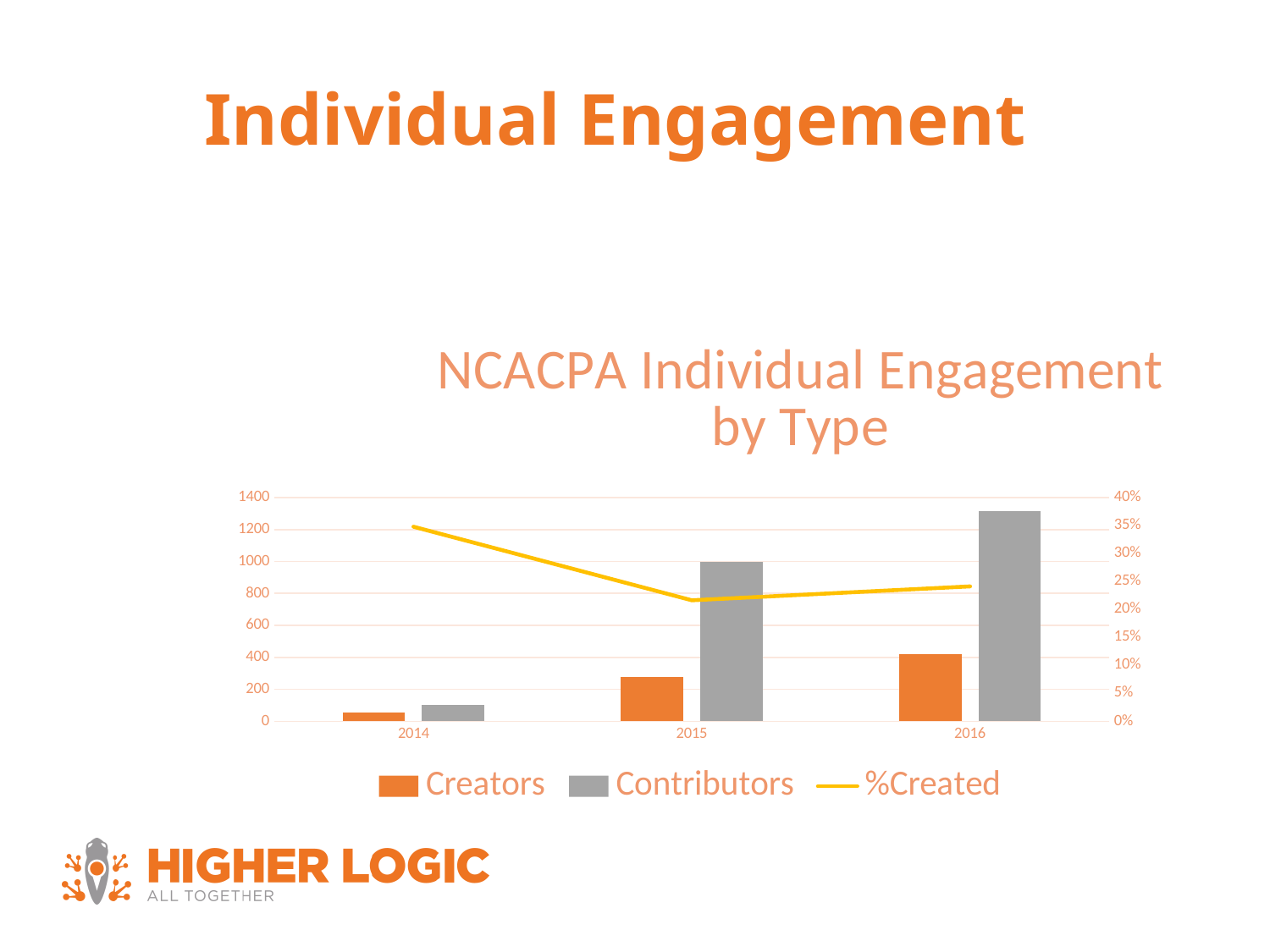
Is the %Created value for 2014 greater or less than 30%? greater Which year has the highest number of Contributors? 2016 Is the value for Creators in 2015 greater or less than 400? less How many years are shown on the x axis of the chart? 3 How many series does the chart legend list? 3 Which year has the highest %Created value? 2014 In 2015, which is larger: Creators or Contributors? Contributors What is the title of the chart? NCACPA Individual Engagement by Type Do the Contributors values rise or fall from 2014 to 2016? rise Is the value for Contributors in 2016 greater or less than 1200? greater Which year has the lowest number of Creators? 2014